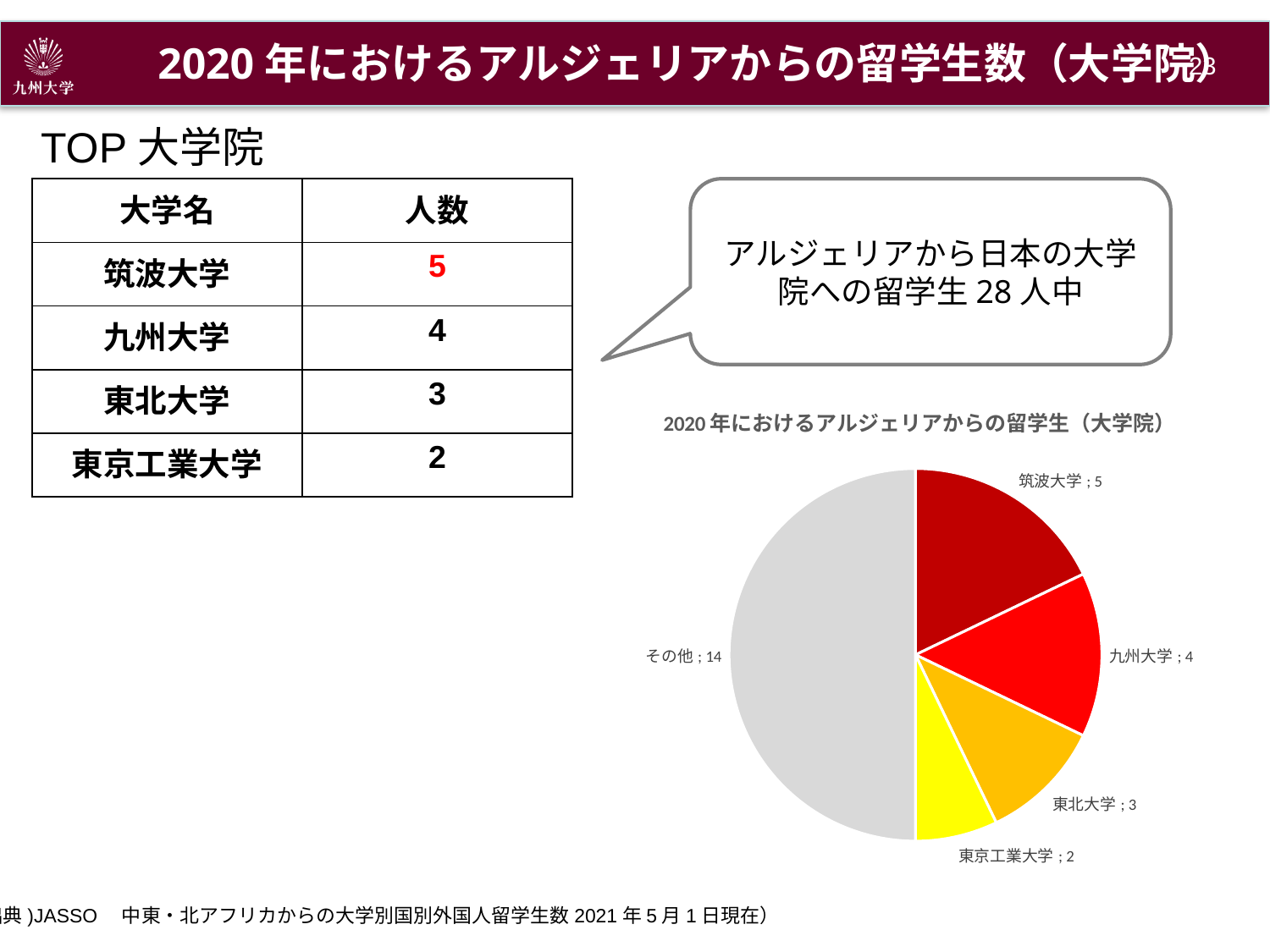
Which slice of the pie chart is the smallest? 東京工業大学 Which is larger in the pie chart, 九州大学 or 東北大学? 九州大学 How many slices does the pie chart have? 5 In the pie chart, what is the value for 筑波大学? 5 What is the difference between the values for 筑波大学 and 東北大学 in the pie chart? 2 In the pie chart, what is the value for その他? 14 In the pie chart, what is the value for 東京工業大学? 2 What kind of chart is shown on the slide? pie chart In the pie chart, what is the value for 九州大学? 4 What share of the pie chart does その他 represent? 50% Which slice of the pie chart is the largest? その他 What is the title of the pie chart? 2020年におけるアルジェリアからの留学生（大学院）